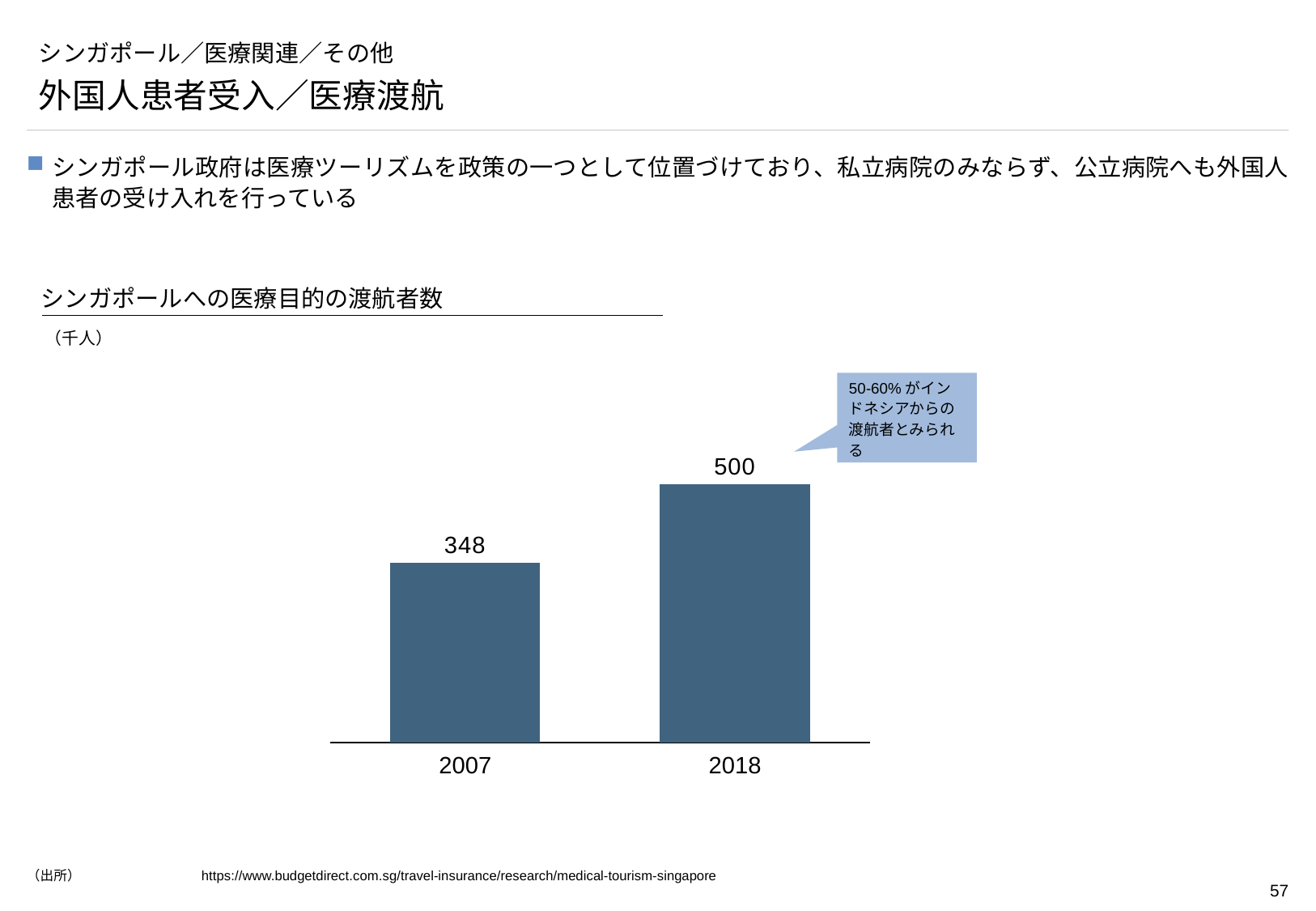
How many bars are shown in the chart? 2 What is the value for 2007? 348 Which year has the higher value? 2018 Do the values rise or fall from 2007 to 2018? Rise What is the difference between the 2018 value and the 2007 value? 152 What kind of chart is shown on the slide? Bar chart Is the value for 2018 larger than the value for 2007? Yes What is the value for 2018? 500 What unit is shown for the chart values? 千人 Which year has the lower value? 2007 What is the title of the chart? シンガポールへの医療目的の渡航者数